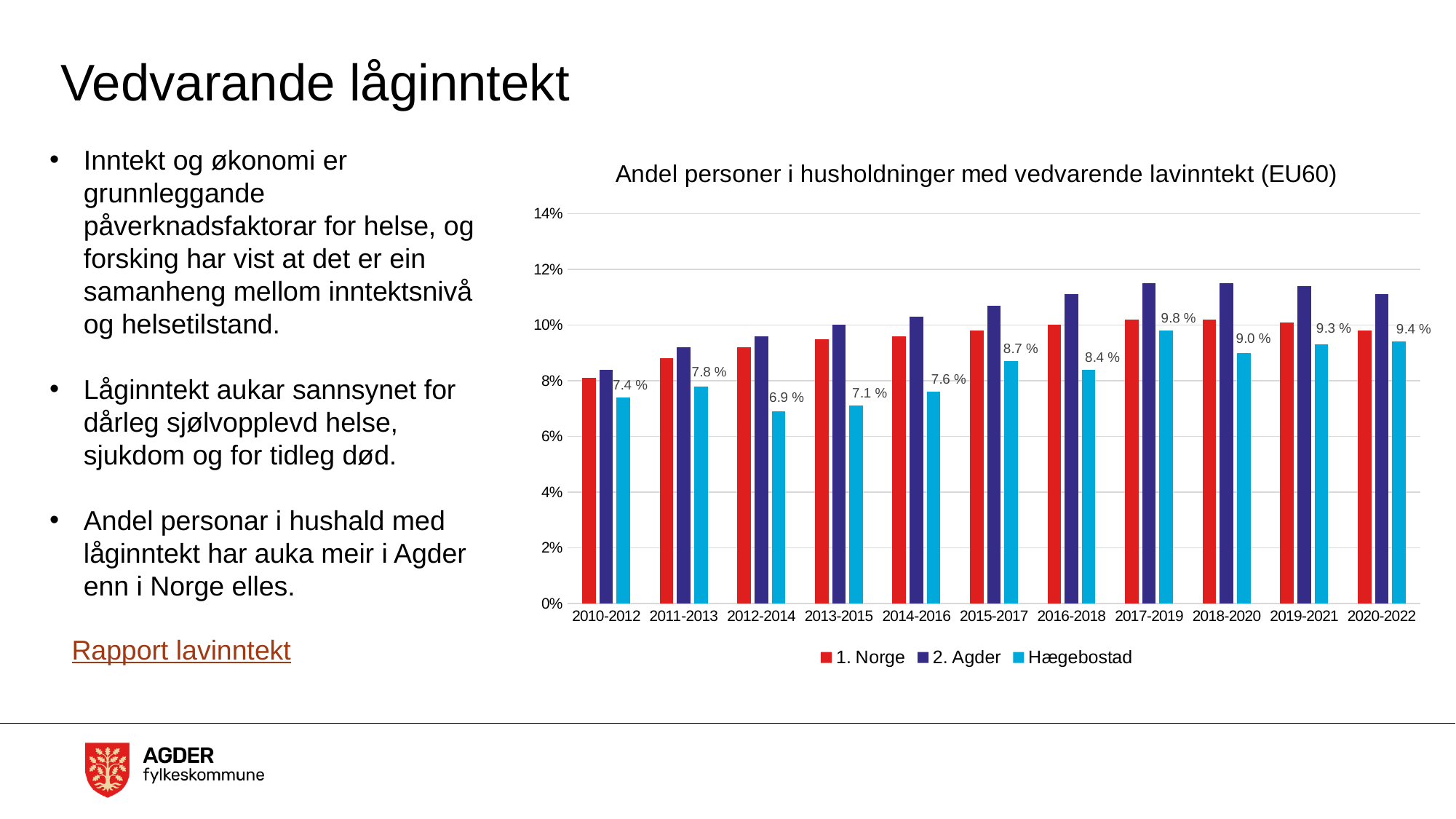
Is the value for 2. Agder in 2017-2019 greater or less than 10%? greater How many series does the legend list? 3 What is the difference between the Hægebostad values for 2020-2022 and 2010-2012? 2.0 % In 2018-2020, which is larger: the value for 1. Norge or for 2. Agder? 2. Agder What kind of chart is shown on the slide? bar chart In which period is the Hægebostad value highest? 2017-2019 What is the title of the chart? Andel personer i husholdninger med vedvarende lavinntekt (EU60) In which period is the Hægebostad value lowest? 2012-2014 What is the value for Hægebostad in 2010-2012? 7.4 % Is the value for 1. Norge in 2010-2012 greater or less than 10%? less How many time periods are shown on the x axis? 11 What is the value for Hægebostad in 2017-2019? 9.8 %